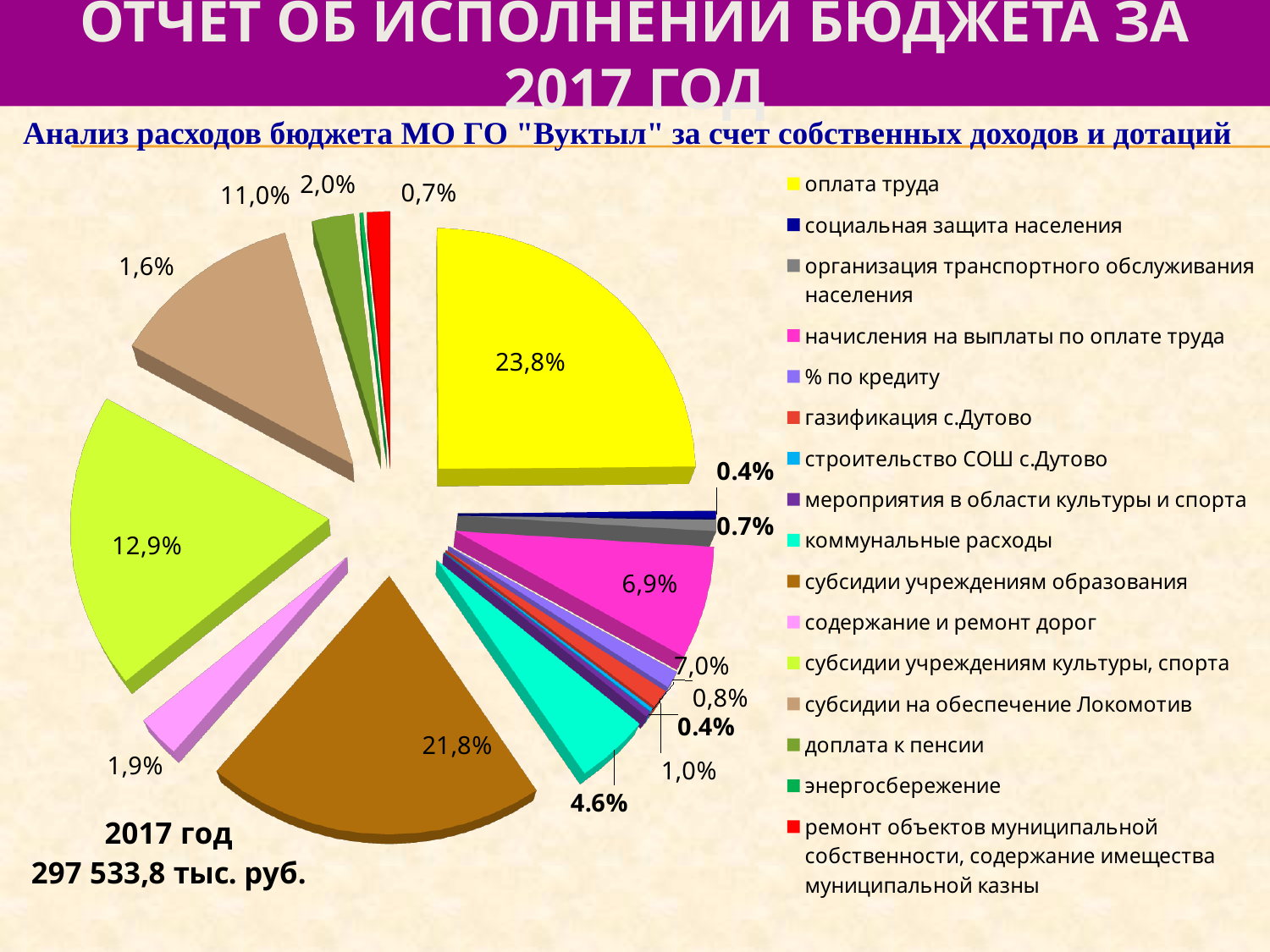
What is the difference in percentage points between the share for оплата труда and the share for субсидии учреждениям образования? 2,0 Which is larger: the share for оплата труда or the share for субсидии учреждениям образования? оплата труда What colour is the slice for оплата труда? yellow What share of the pie is labelled for субсидии учреждениям культуры, спорта? 12,9% What share of the pie is labelled for субсидии учреждениям образования? 21,8% What kind of chart is shown on the slide? pie chart How many categories does the legend of the pie chart list? 16 What total amount in тыс. руб. is stated for 2017 год below the pie chart? 297 533,8 тыс. руб. Which category has the largest share of the pie? оплата труда What share of the pie is labelled for начисления на выплаты по оплате труда? 6,9% What share of the pie is labelled for коммунальные расходы? 4.6% What share of the pie is labelled for оплата труда? 23,8%